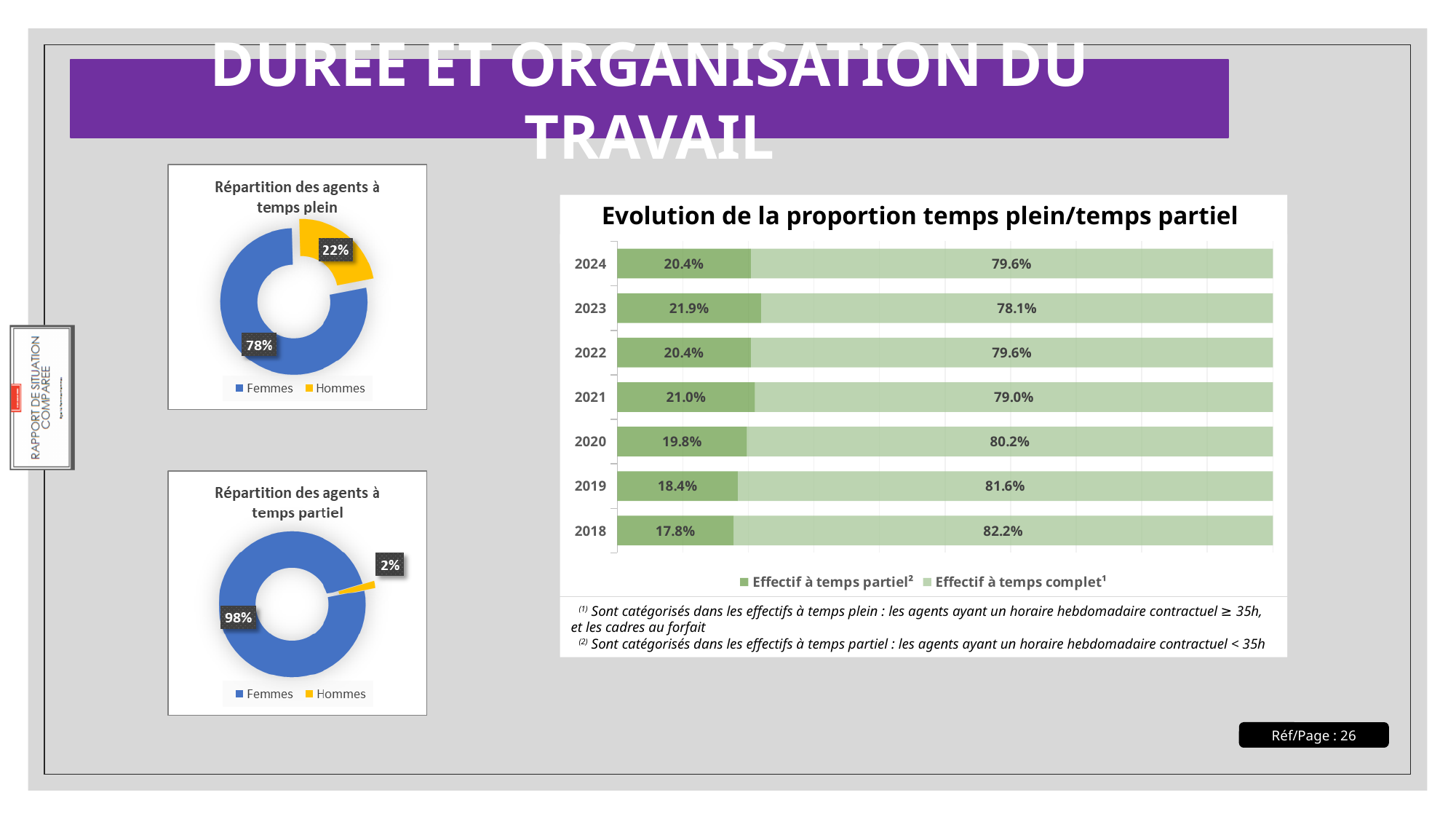
In the 'Evolution de la proportion temps plein/temps partiel' chart, is the 'Effectif à temps complet' value larger in 2019 or in 2021? 2019 In the 'Evolution de la proportion temps plein/temps partiel' chart, which year has the highest 'Effectif à temps partiel' share? 2023 In the 'Evolution de la proportion temps plein/temps partiel' chart, what is the difference between the 'Effectif à temps partiel' values for 2023 and 2018? 4.1% In the 'Répartition des agents à temps plein' chart, what share is 'Hommes'? 22% What kind of chart is 'Répartition des agents à temps partiel'? Doughnut chart What kind of chart is 'Evolution de la proportion temps plein/temps partiel'? Stacked bar chart In the 'Répartition des agents à temps partiel' chart, what share is 'Femmes'? 98% How many series does the legend of the 'Evolution de la proportion temps plein/temps partiel' chart list? 2 In the 'Evolution de la proportion temps plein/temps partiel' chart, which year has the lowest 'Effectif à temps partiel' share? 2018 In the 'Evolution de la proportion temps plein/temps partiel' chart, what is the value for 'Effectif à temps partiel' in 2024? 20.4% How many years are shown in the 'Evolution de la proportion temps plein/temps partiel' chart? 7 In the 'Evolution de la proportion temps plein/temps partiel' chart, what is the value for 'Effectif à temps complet' in 2018? 82.2%